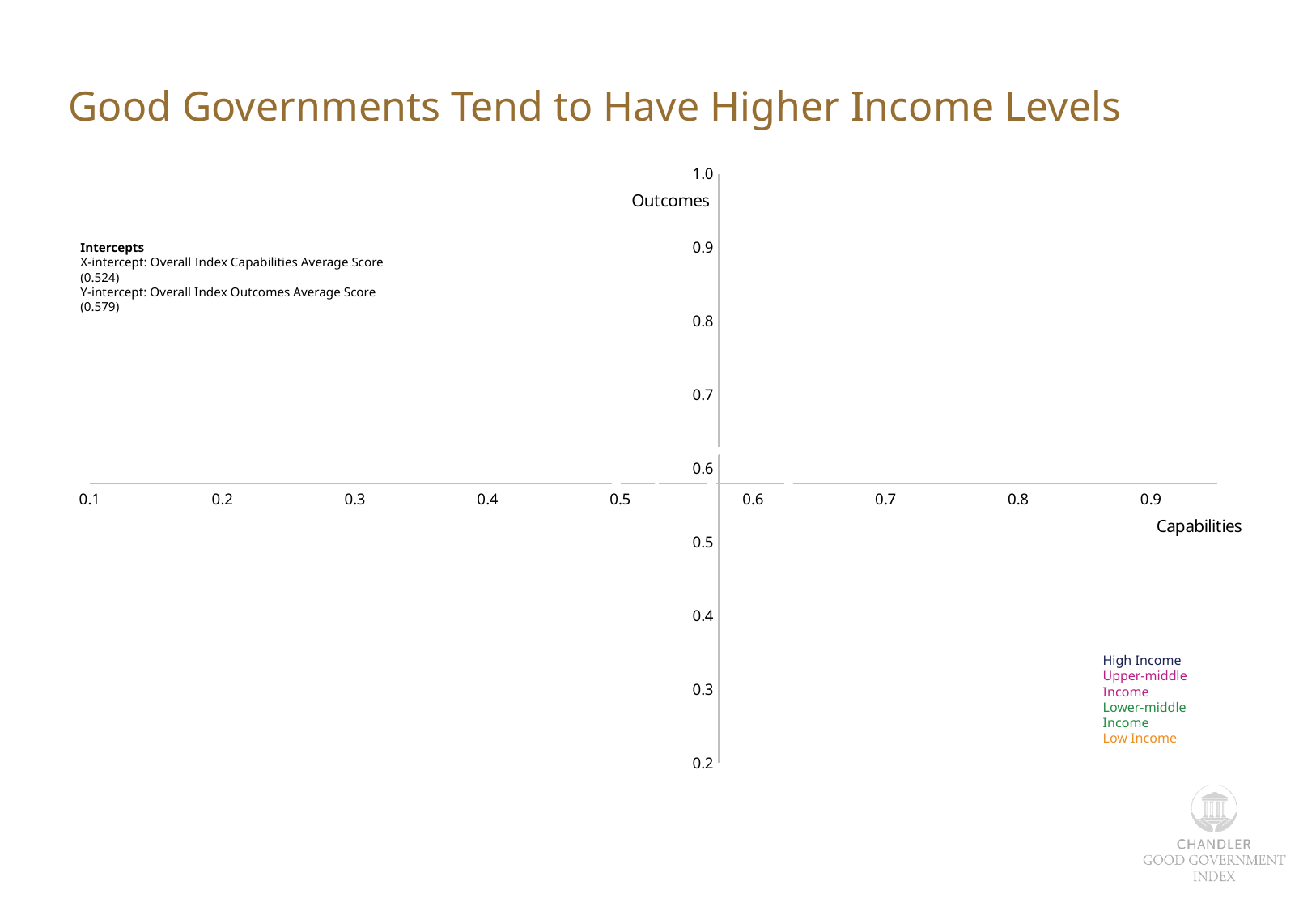
How many income groups does the legend list? 4 What is the label of the horizontal axis? Capabilities What is the X-intercept value (Overall Index Capabilities Average Score) stated on the slide? 0.524 What is the label of the vertical axis? Outcomes What kind of chart is shown on the slide? Scatter chart What is the Y-intercept value (Overall Index Outcomes Average Score) stated on the slide? 0.579